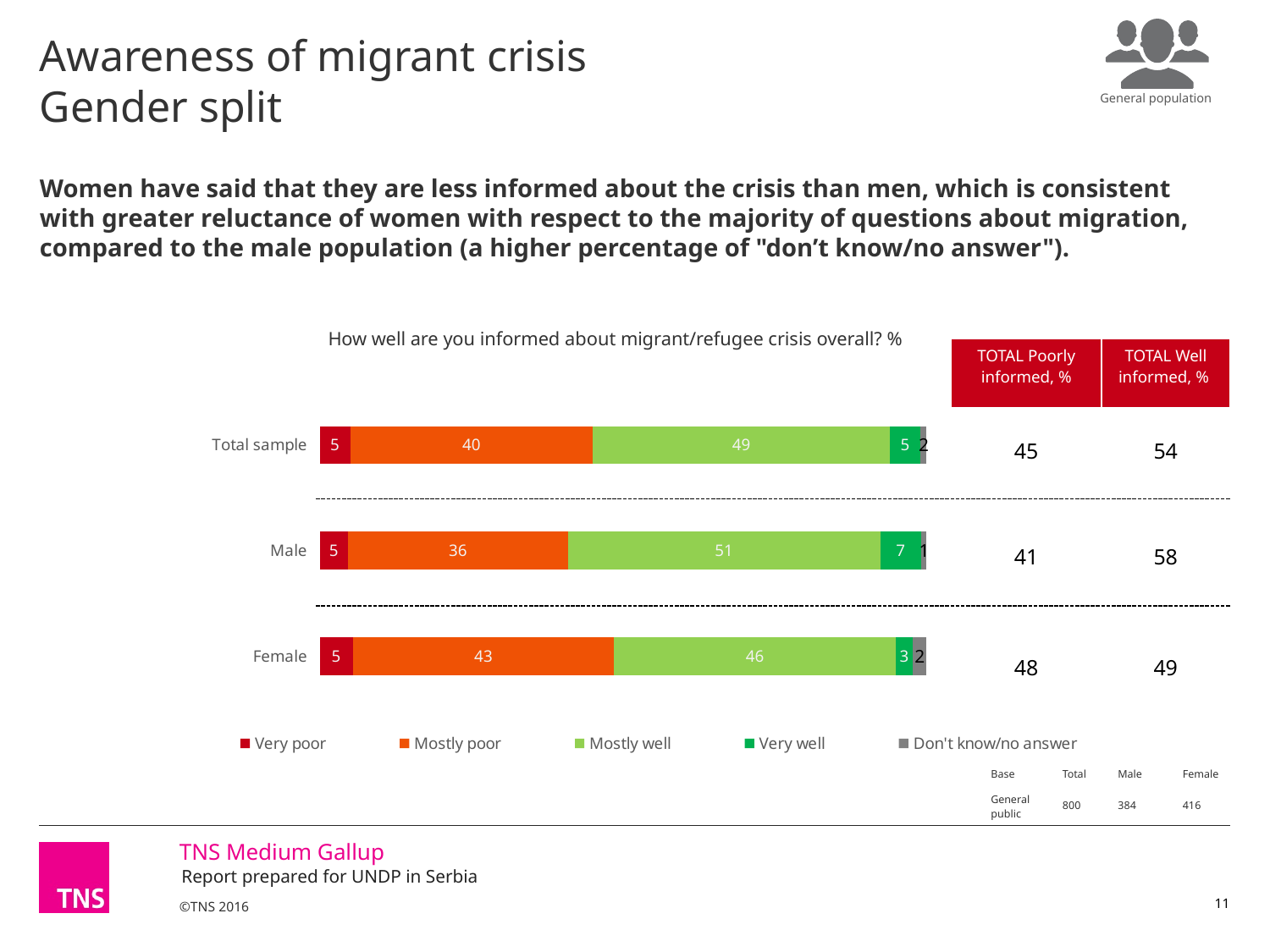
Which category has the lowest 'Very well' value? Female How many categories (bars) are plotted in the chart? 3 Which is larger: the 'Mostly well' value for Female or for Total sample? Total sample What is the 'Mostly well' value for the Male bar? 51 What is the 'Mostly poor' value for the Female bar? 43 What is the title of the chart? How well are you informed about migrant/refugee crisis overall? % What is the 'Very well' value for the Total sample bar? 5 What is the difference between the 'Mostly poor' values for Female and Male? 7 What is the total of the stacked Male bar? 100 What type of chart is shown on the slide? stacked bar chart How many series does the chart legend list? 5 Which category has the highest 'Mostly well' value? Male